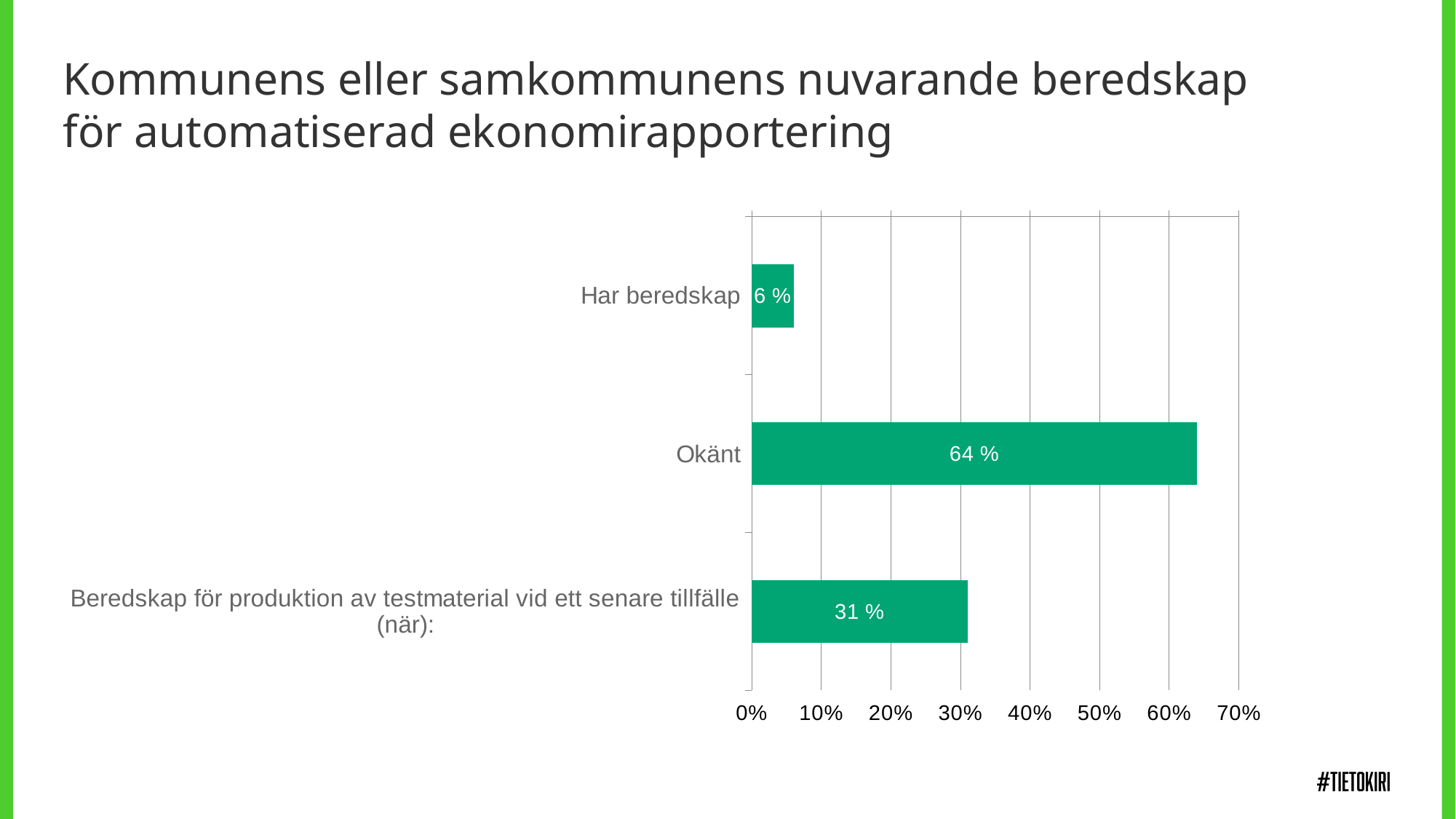
How many categories are shown in the chart? 3 What is the value for "Beredskap för produktion av testmaterial vid ett senare tillfälle (när):"? 31 % Which is larger, the value for "Okänt" or the value for "Har beredskap"? Okänt Which category has the highest value? Okänt What kind of chart is shown on the slide? bar chart What is the difference between the values for "Beredskap för produktion av testmaterial vid ett senare tillfälle (när):" and "Har beredskap"? 25 % Which category has the lowest value? Har beredskap What is the value for "Okänt"? 64 % What is the highest value shown on the x axis? 70% What is the value for "Har beredskap"? 6 % What is the difference between the values for "Okänt" and "Beredskap för produktion av testmaterial vid ett senare tillfälle (när):"? 33 % Is the value for "Okänt" greater or less than 50%? greater